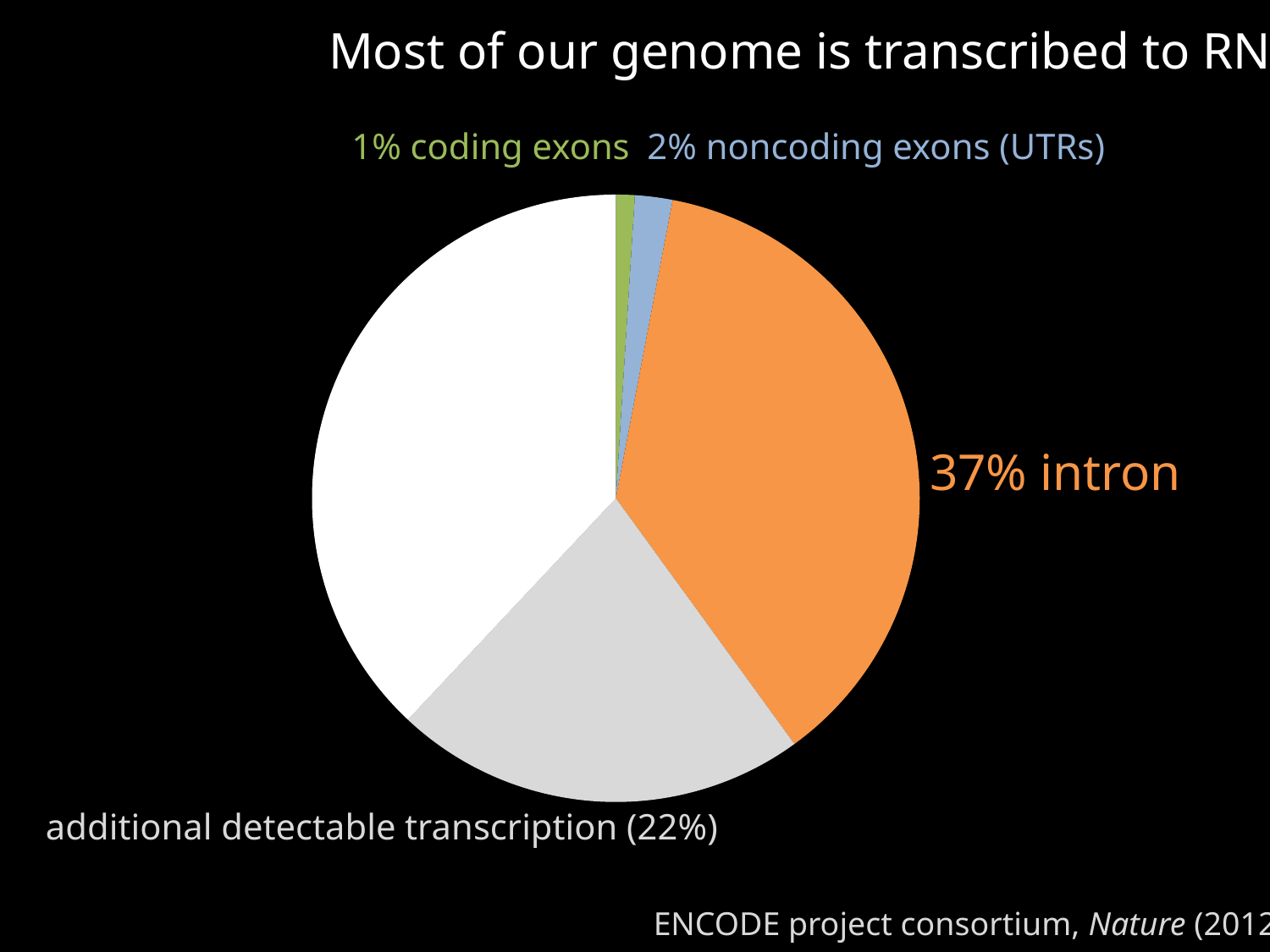
By how many percentage points does the intron share exceed the additional detectable transcription share? 15% Which is larger, the intron slice or the additional detectable transcription slice? intron How many slices does the pie chart have? 5 Which labelled slice of the pie is the smallest? coding exons What share of the pie is labelled as intron? 37% What percentage is given for additional detectable transcription? 22% What colour is the intron slice of the pie? orange By how many percentage points does the noncoding exons (UTRs) share exceed the coding exons share? 1% What percentage is given for coding exons? 1% Which is larger, the coding exons slice or the noncoding exons (UTRs) slice? noncoding exons (UTRs) What kind of chart is shown on the slide? pie chart What percentage is given for noncoding exons (UTRs)? 2%